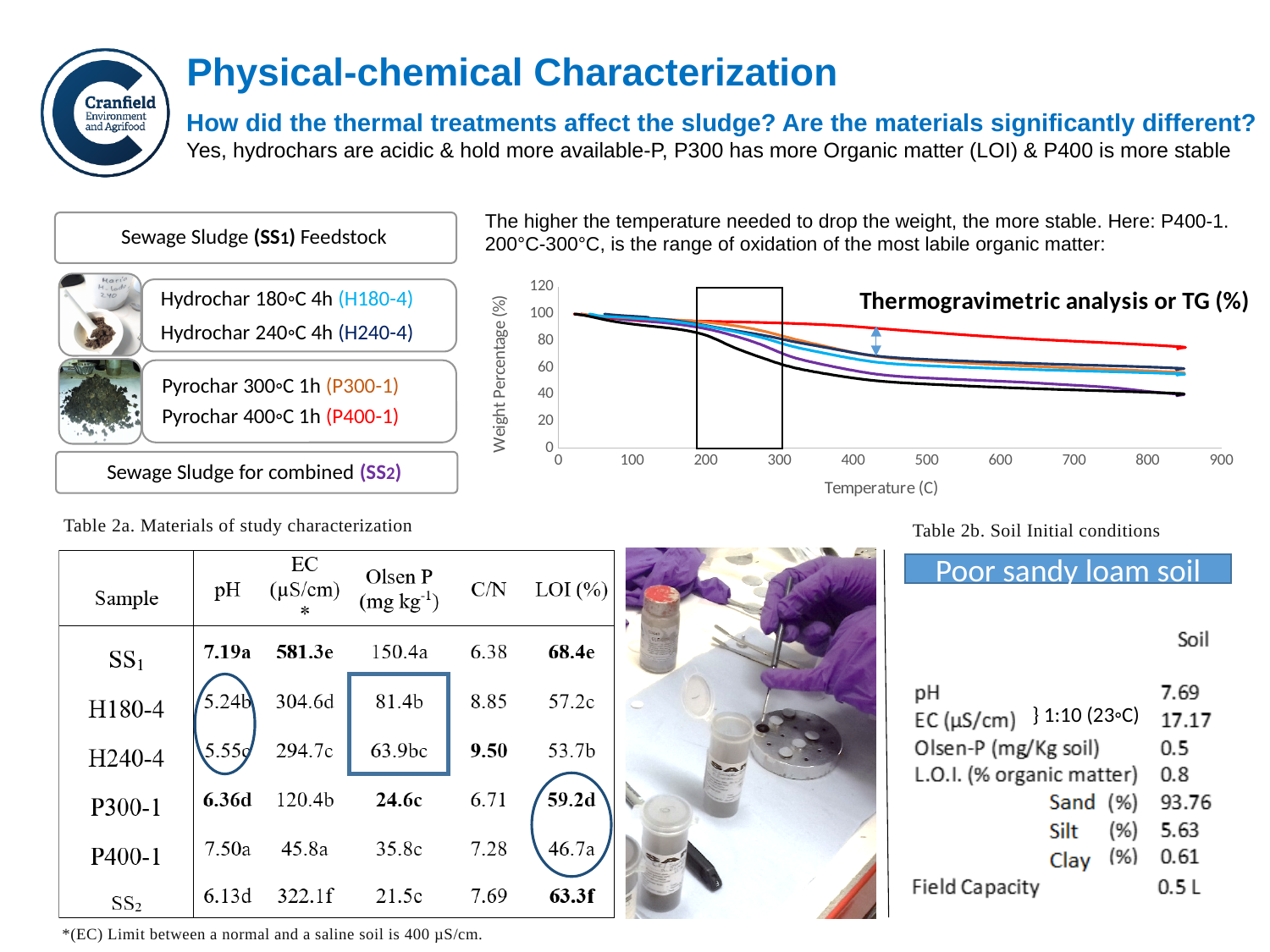
What kind of chart is the Thermogravimetric analysis chart? line chart In the Thermogravimetric analysis chart, is the weight percentage of the red line at 300°C greater or less than 80? greater What is the label of the x axis of the Thermogravimetric analysis chart? Temperature (C) In the Thermogravimetric analysis chart, do the weight percentage values rise or fall as temperature increases? fall What is the title of the chart on the slide? Thermogravimetric analysis or TG (%) In the Thermogravimetric analysis chart, is the weight percentage of the black line at 400°C greater or less than 60? less In the Thermogravimetric analysis chart, is the weight percentage of the red line at 500°C greater or less than 60? greater In the Thermogravimetric analysis chart, at 600°C, which line has the larger weight percentage, the red line or the black line? red What is the highest tick value shown on the y axis of the Thermogravimetric analysis chart? 120 In the Thermogravimetric analysis chart, which coloured line has the highest weight percentage at 800°C? red In the Thermogravimetric analysis chart, which coloured line has the lowest weight percentage at 800°C? black